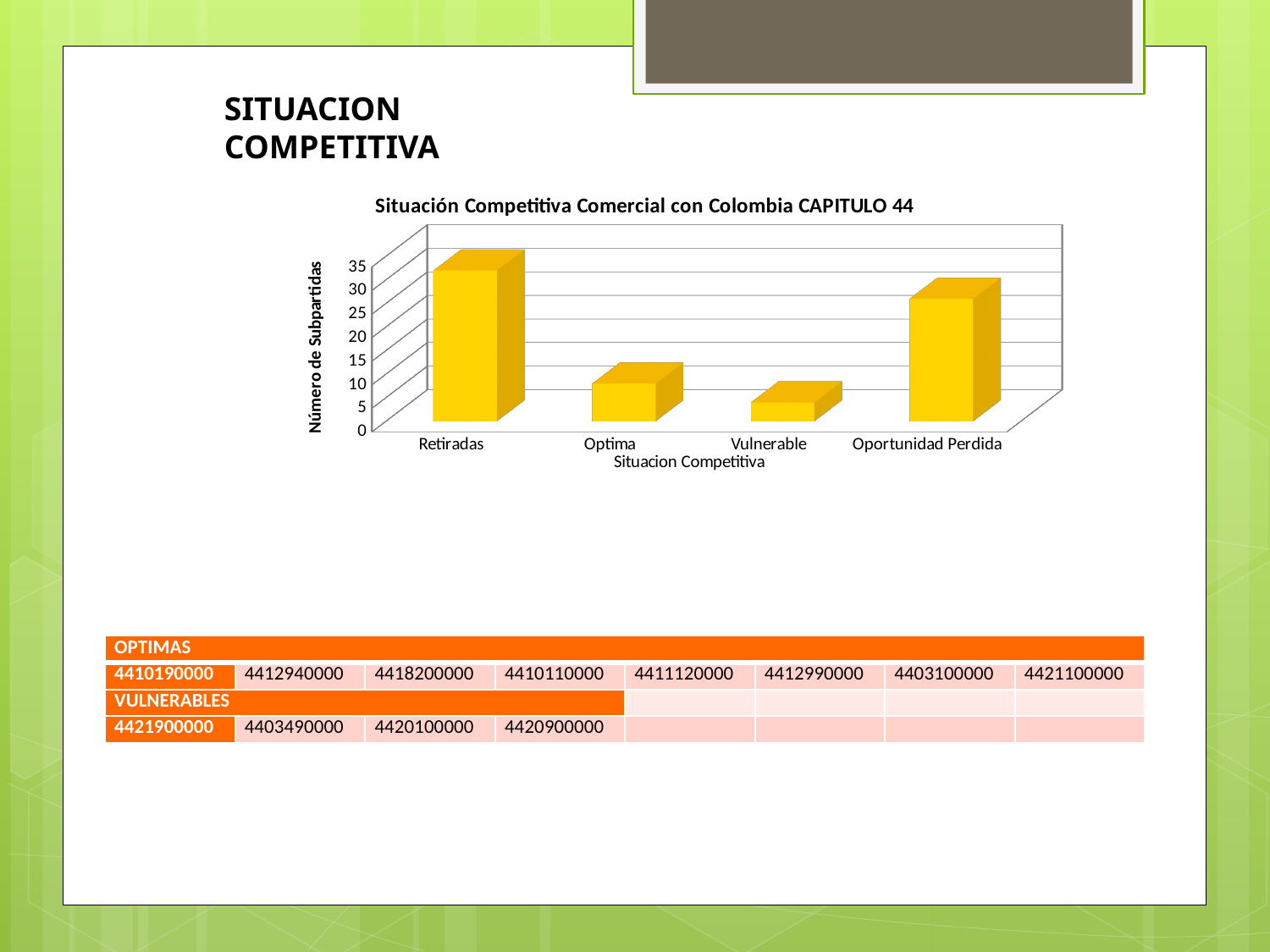
Which category has the lowest number of subpartidas? Vulnerable Is the value for Retiradas greater or less than 25? greater What kind of chart is shown on the slide? bar chart Is the value for Vulnerable greater or less than 10? less Which is larger, the value for Retiradas or the value for Optima? Retiradas What is the label of the vertical axis of the chart? Número de Subpartidas Is the value for Optima greater or less than 15? less What is the title of the chart? Situación Competitiva Comercial con Colombia CAPITULO 44 Which is larger, the value for Oportunidad Perdida or the value for Vulnerable? Oportunidad Perdida How many categories are shown on the x axis of the chart? 4 Which category has the highest number of subpartidas? Retiradas